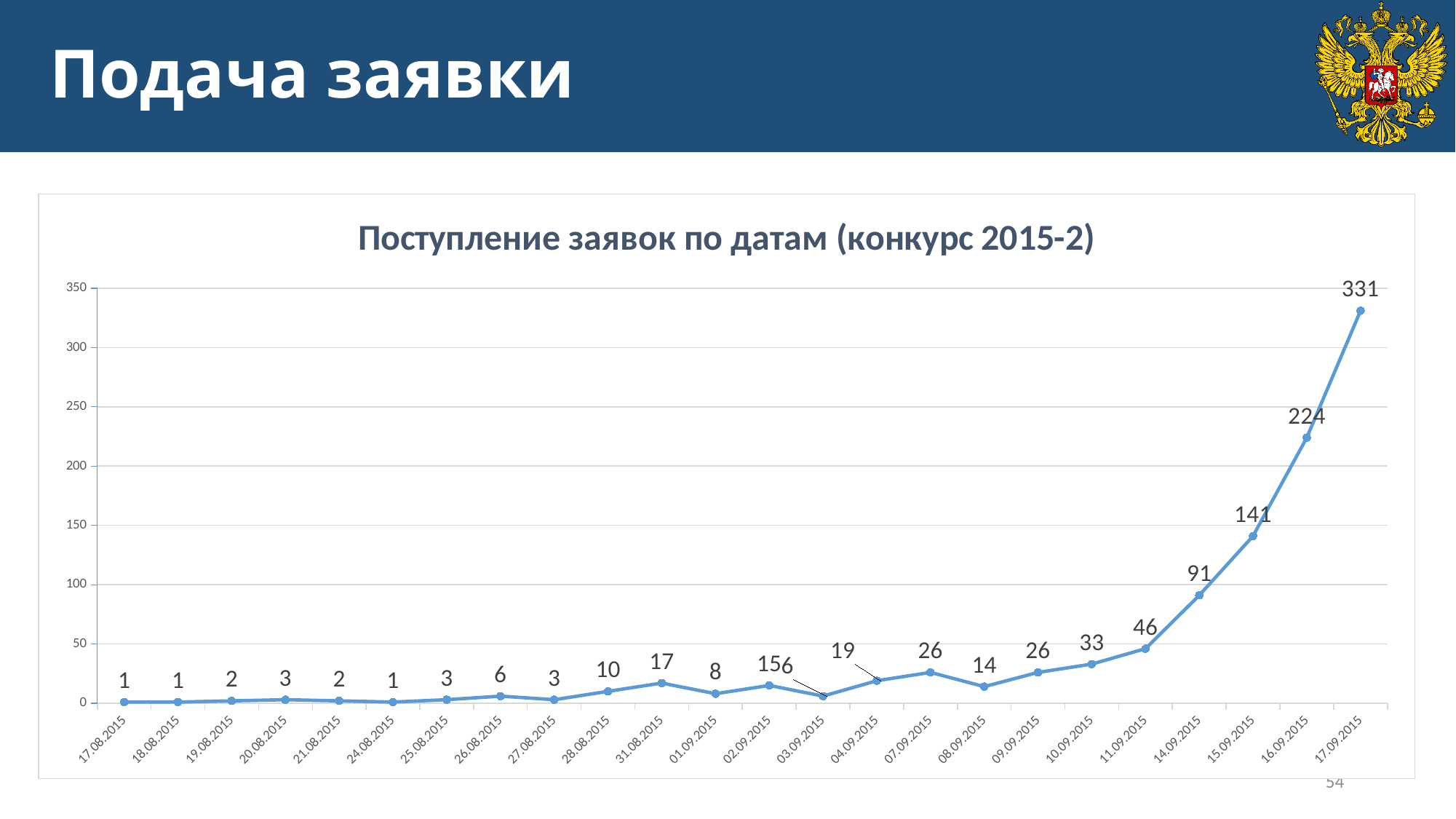
Do the values generally rise or fall from 10.09.2015 to 17.09.2015? rise What is the value for 17.09.2015? 331 What is the value for 31.08.2015? 17 What is the difference between the values for 17.09.2015 and 16.09.2015? 107 How many dates are plotted on the x axis? 24 What kind of chart is shown? line chart Which is larger, the value for 14.09.2015 or the value for 15.09.2015? 15.09.2015 What is the value for 11.09.2015? 46 What is the value for 16.09.2015? 224 Is the value for 15.09.2015 greater or less than 100? greater Which date has the highest value? 17.09.2015 What is the title of the chart? Поступление заявок по датам (конкурс 2015-2)